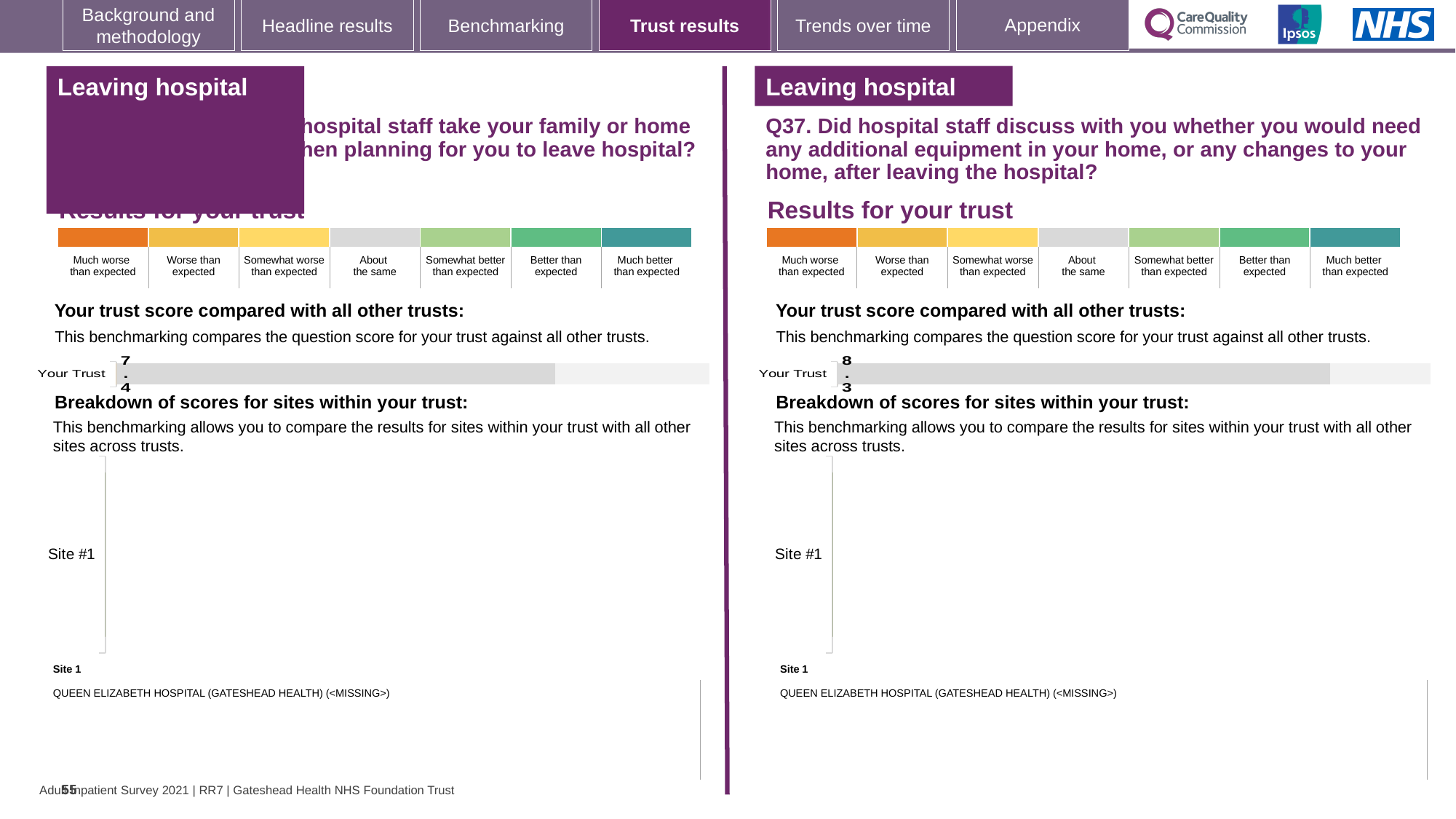
On the left-hand 'Your trust score compared with all other trusts' chart, what is the value shown for Your Trust? 7.4 On the right-hand Q37 'Results for your trust' colour scale, how many rating bands are shown? 7 What is the difference between the Your Trust score on the right-hand Q37 chart and the Your Trust score on the left-hand chart? 0.9 On the left-hand 'Your trust score compared with all other trusts' chart, how many categories are plotted? 1 On the right-hand chart for Q37 ('Your trust score compared with all other trusts'), what is the value shown for Your Trust? 8.3 On the right-hand Q37 'Breakdown of scores for sites within your trust' chart, how many sites are listed on the axis? 1 Which chart shows the higher Your Trust score: the left-hand chart or the right-hand Q37 chart? the right-hand Q37 chart What is the category label on the left-hand 'Your trust score compared with all other trusts' chart? Your Trust What kind of chart is used to show the Your Trust score on the right-hand Q37 chart? bar chart